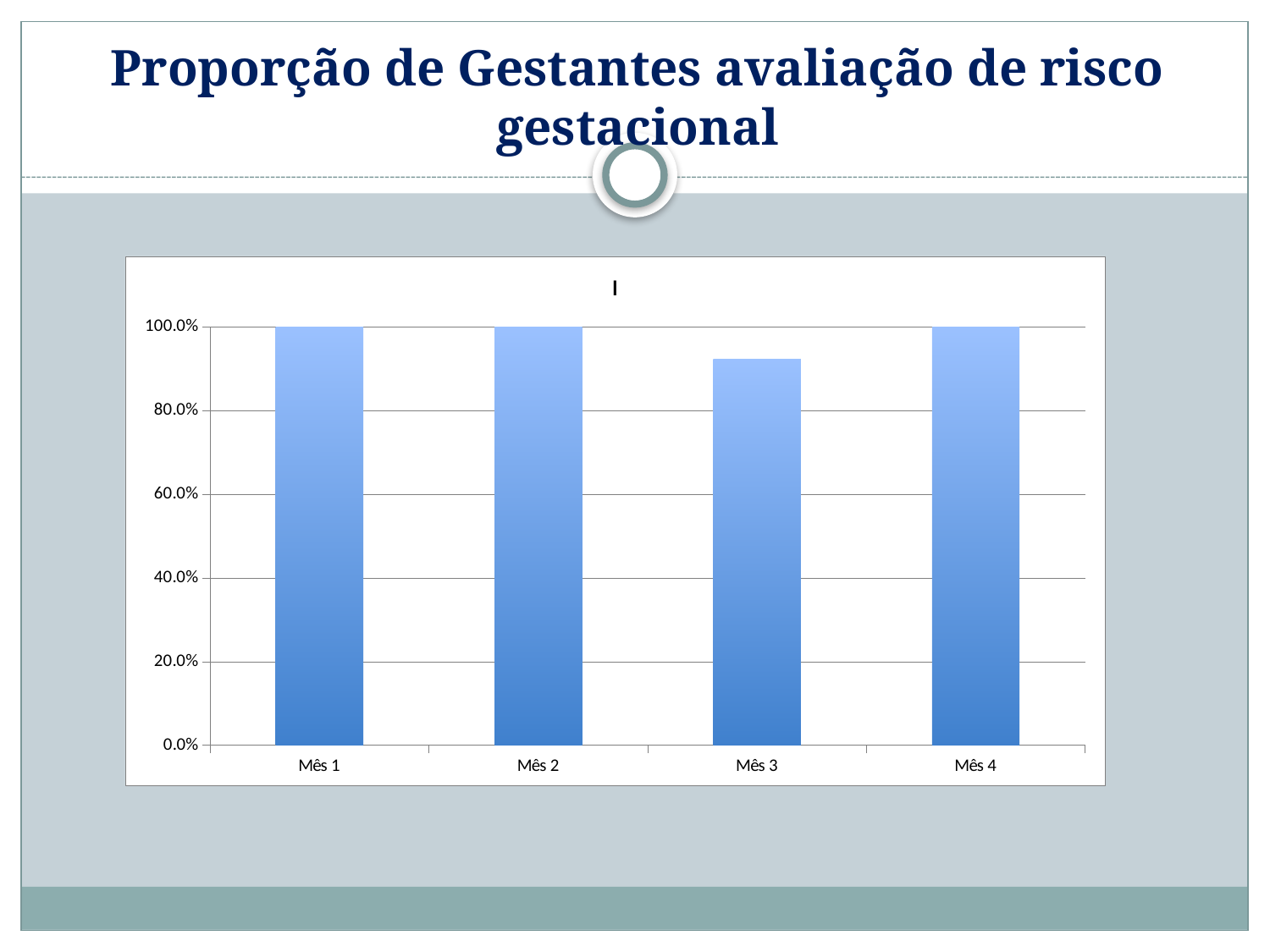
How many categories are shown on the x axis of the chart? 4 What is the value for Mês 4? 100.0% Which month has the lowest value in the chart? Mês 3 What is the value for Mês 1? 100.0% What kind of chart is shown on the slide? bar chart What is the label of the first category on the x axis? Mês 1 Which is larger, the value for Mês 2 or the value for Mês 3? Mês 2 Is the value for Mês 3 greater or less than 80.0%? greater Is the value for Mês 3 greater or less than 100.0%? less What is the title of the slide? Proporção de Gestantes avaliação de risco gestacional